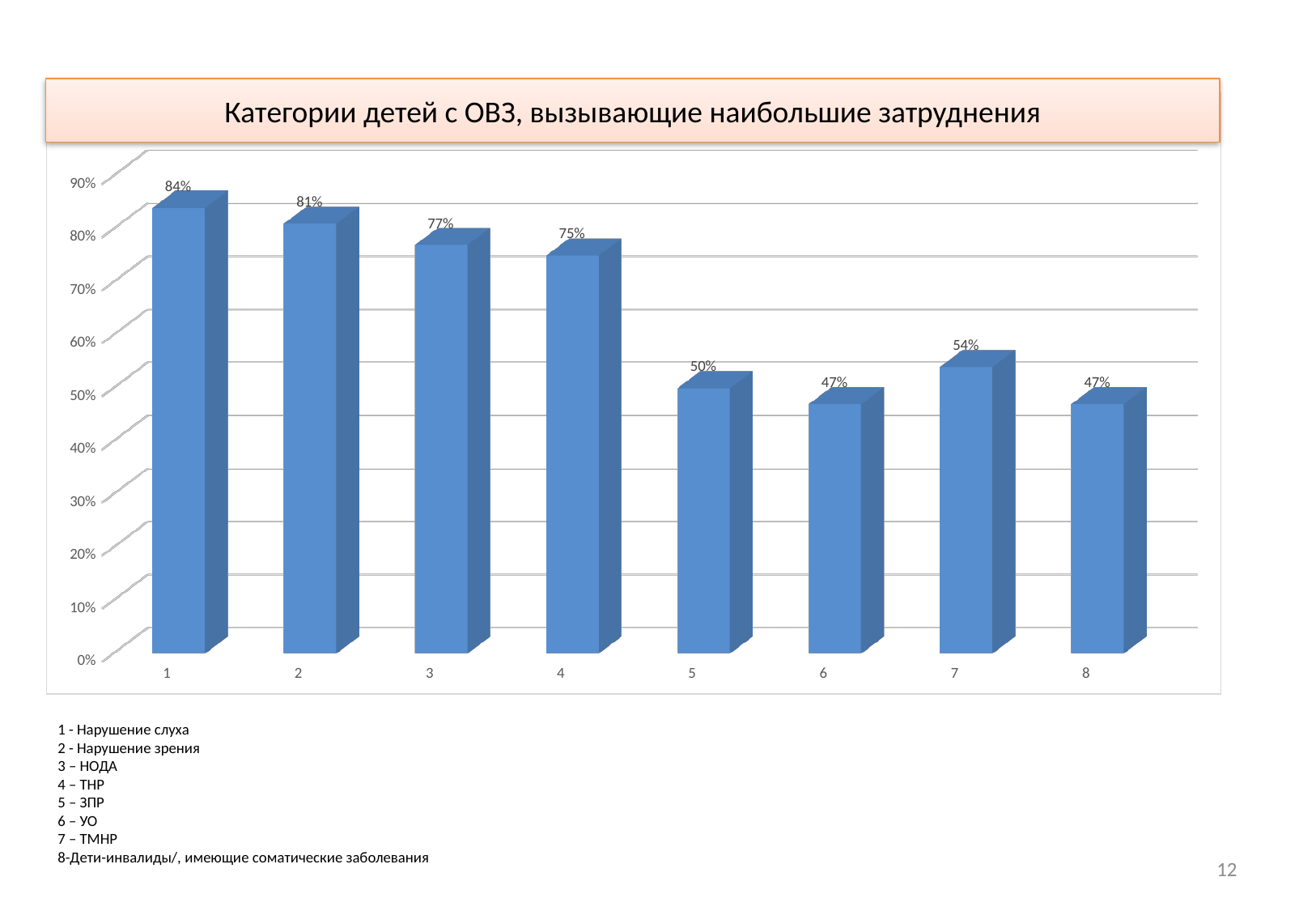
What is the title of the chart? Категории детей с ОВЗ, вызывающие наибольшие затруднения Is the value for category 6 greater or less than 50%? less What is the value for category 1 (Нарушение слуха)? 84% How many categories are shown on the x axis? 8 What is the difference between the values for category 1 and category 2? 3% Which is larger, the value for category 3 or the value for category 7? category 3 What is the value for category 5 (ЗПР)? 50% What kind of chart is shown on the slide? bar chart Which category has the highest value? 1 Do the values rise or fall from category 1 to category 4? fall What is the difference between the values for category 4 and category 5? 25% What is the value for category 7 (ТМНР)? 54%